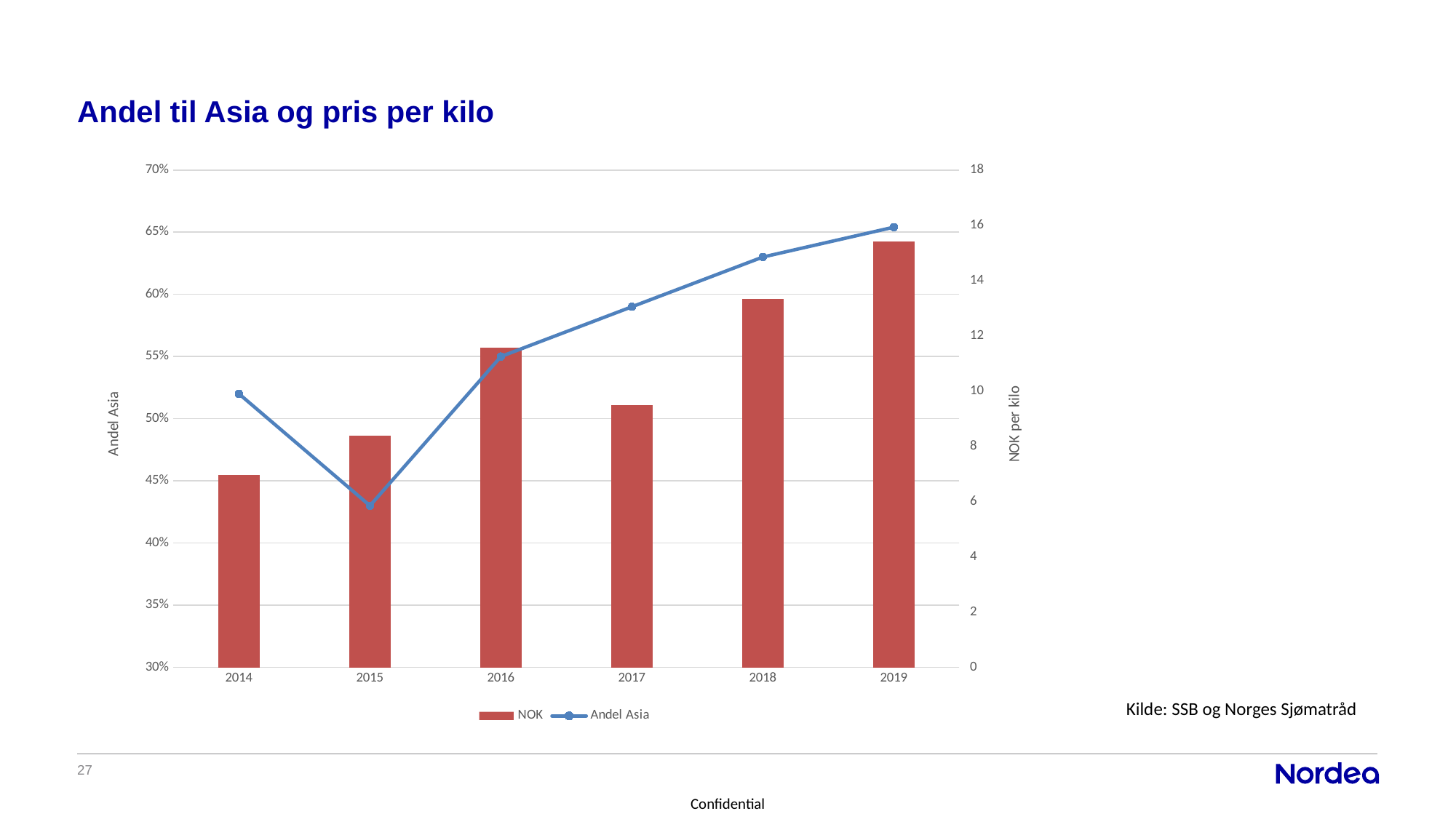
Which year has the lowest Andel Asia value on the line? 2015 How many series does the legend list? 2 How many years are shown on the x axis? 6 Which year has the larger NOK per kilo bar, 2016 or 2017? 2016 What is the label of the right-hand vertical axis? NOK per kilo Which year has the lowest NOK per kilo bar? 2014 What kind of chart is shown on the slide? A combined bar and line chart Which year has the highest Andel Asia value on the line? 2019 Is the NOK per kilo value for 2019 greater or less than 14? greater Does the Andel Asia line rise or fall from 2015 to 2019? Rises Which year has the highest NOK per kilo bar? 2019 Is the Andel Asia value for 2015 greater or less than 45%? less